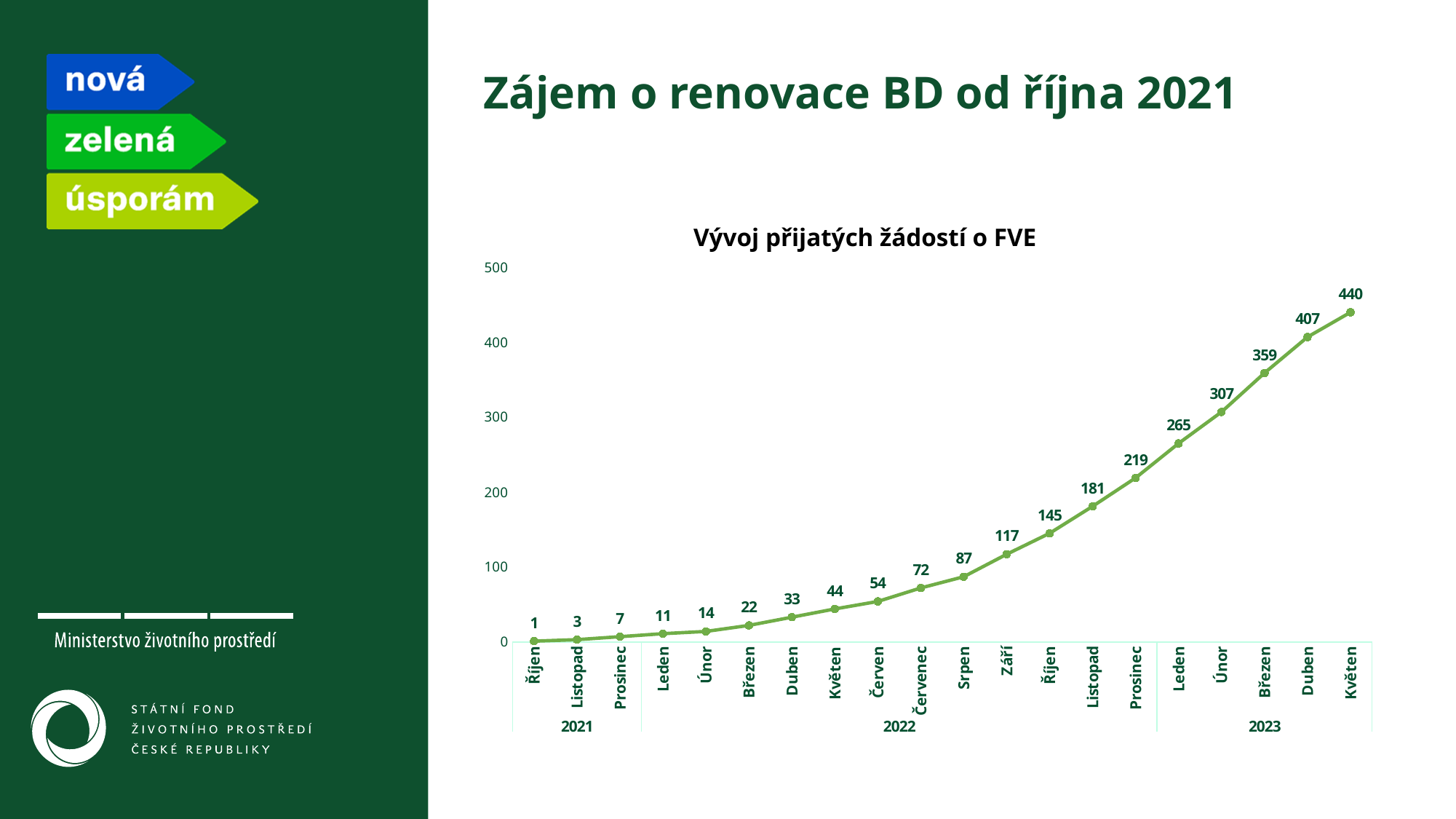
What is the value for Prosinec 2022? 219 What is the value for Květen 2023? 440 What is the difference between the values for Květen 2023 and Duben 2023? 33 What is the title of the chart? Vývoj přijatých žádostí o FVE What is the value for Říjen 2021? 1 Which month has the lowest value? Říjen 2021 What is the difference between the values for Prosinec 2022 and Prosinec 2021? 212 Which is larger, the value for Září 2022 or the value for Srpen 2022? Září 2022 Which month has the highest value? Květen 2023 What kind of chart is shown on the slide? line chart How many data points are plotted on the chart? 20 Do the values rise or fall from Říjen 2021 to Květen 2023? rise